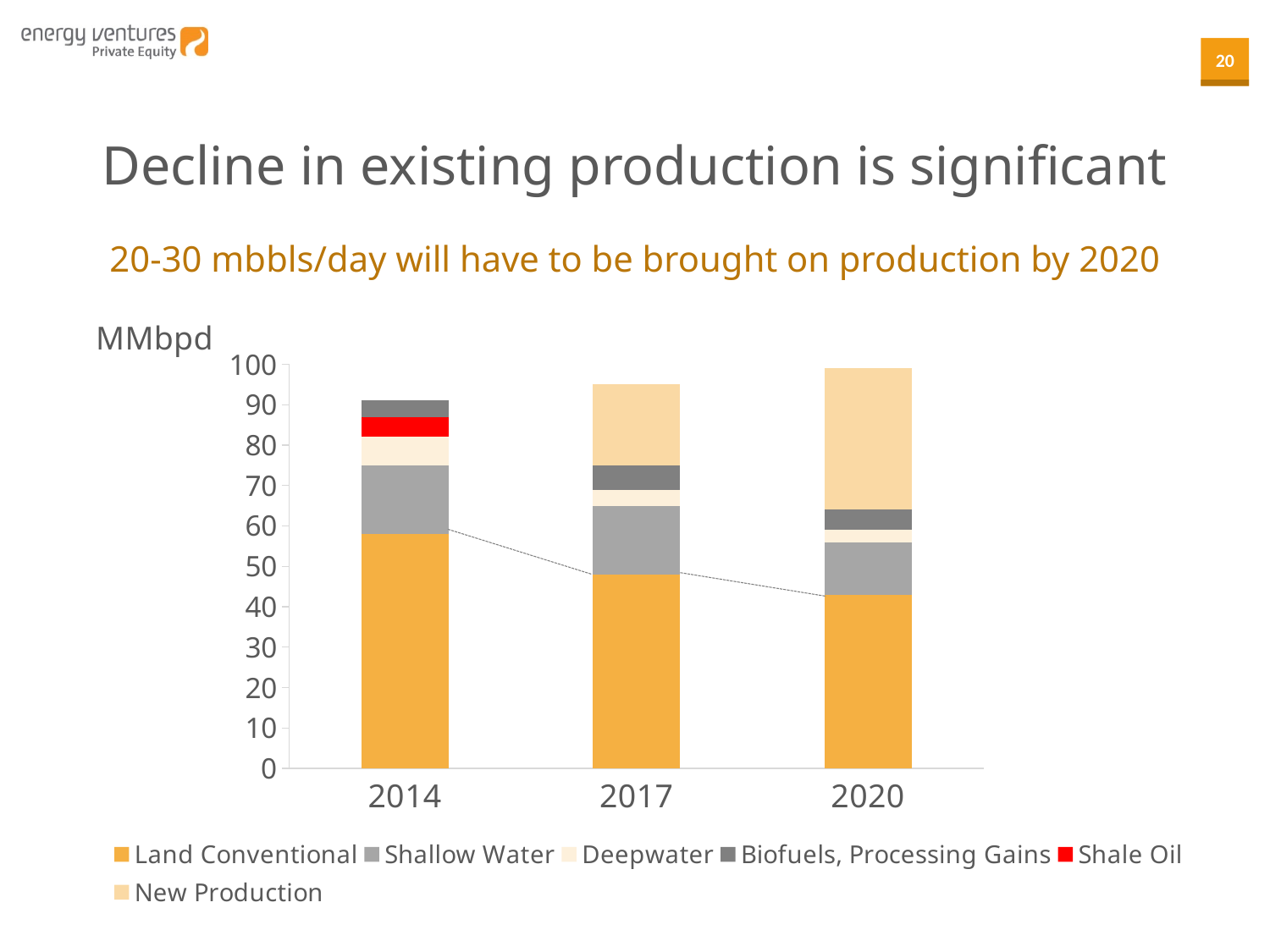
Which year has the smallest Land Conventional segment? 2020 Is the Land Conventional value for 2014 greater or less than 50? greater Does the Land Conventional segment rise or fall from 2014 to 2020? Fall Is the Land Conventional segment larger in 2014 or in 2020? 2014 How many series does the chart legend list? 6 Is the Land Conventional value for 2020 greater or less than 50? less How many years are shown on the x axis of the chart? 3 Which year has the tallest stacked bar? 2020 What kind of chart is shown on the slide? Stacked bar chart Which year has the largest Land Conventional segment? 2014 Is the total height of the 2014 bar greater or less than 100? less What unit label is shown above the y axis of the chart? MMbpd